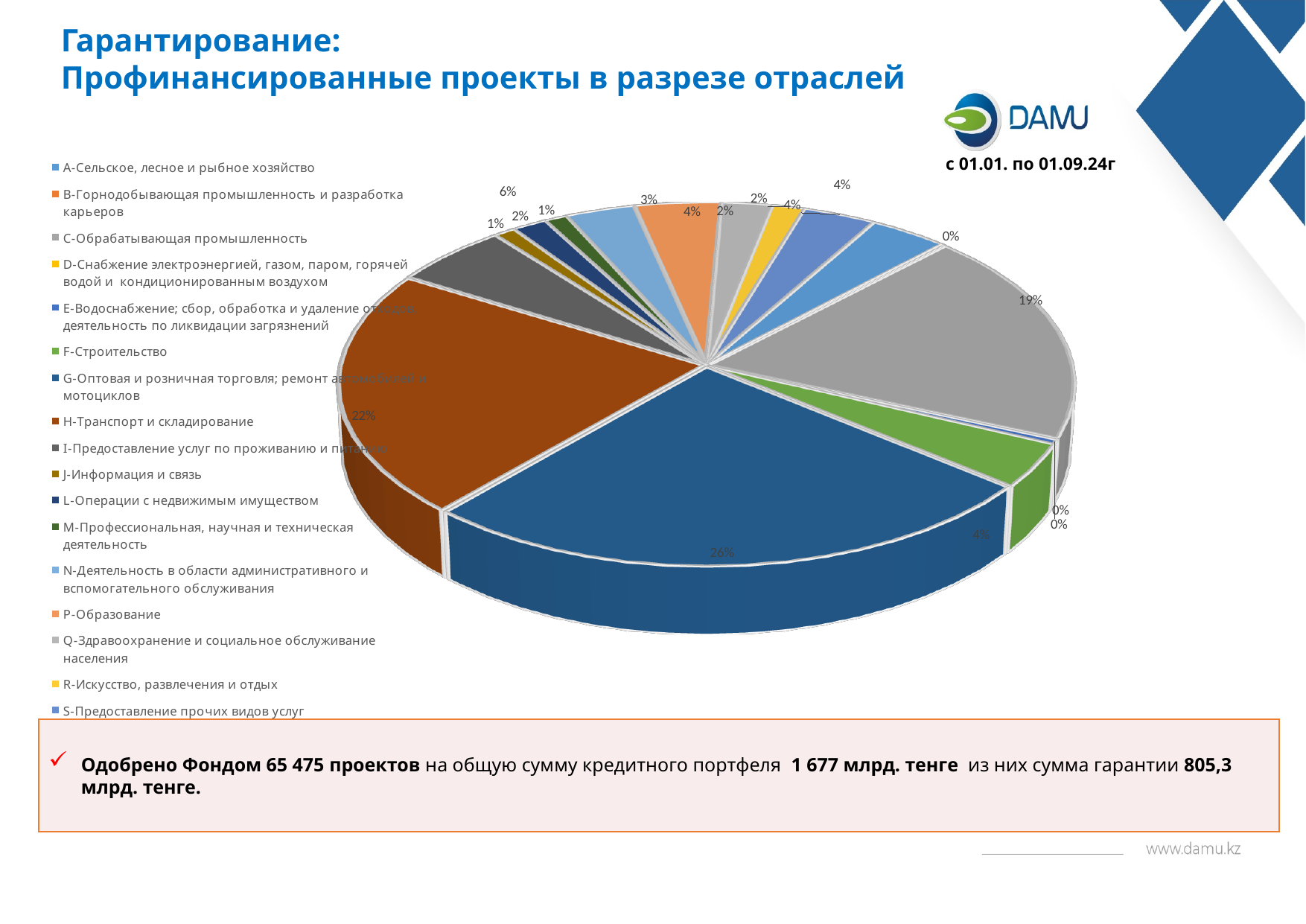
What kind of chart is shown on the slide? pie chart Which sector has the largest share of the pie? G-Оптовая и розничная торговля; ремонт автомобилей и мотоциклов What share of the pie does C-Обрабатывающая промышленность have? 19% Which is larger: the share of H-Транспорт и складирование or the share of C-Обрабатывающая промышленность? H-Транспорт и складирование How many sectors are listed in the chart legend? 17 What share of the pie does H-Транспорт и складирование have? 22% What is the combined share of the three largest slices (G, H and C)? 67% What is the difference in percentage points between the shares of G-Оптовая и розничная торговля and H-Транспорт и складирование? 4 What share of the pie does F-Строительство have? 4% What period does the chart cover, according to the label next to the logo? с 01.01. по 01.09.24г